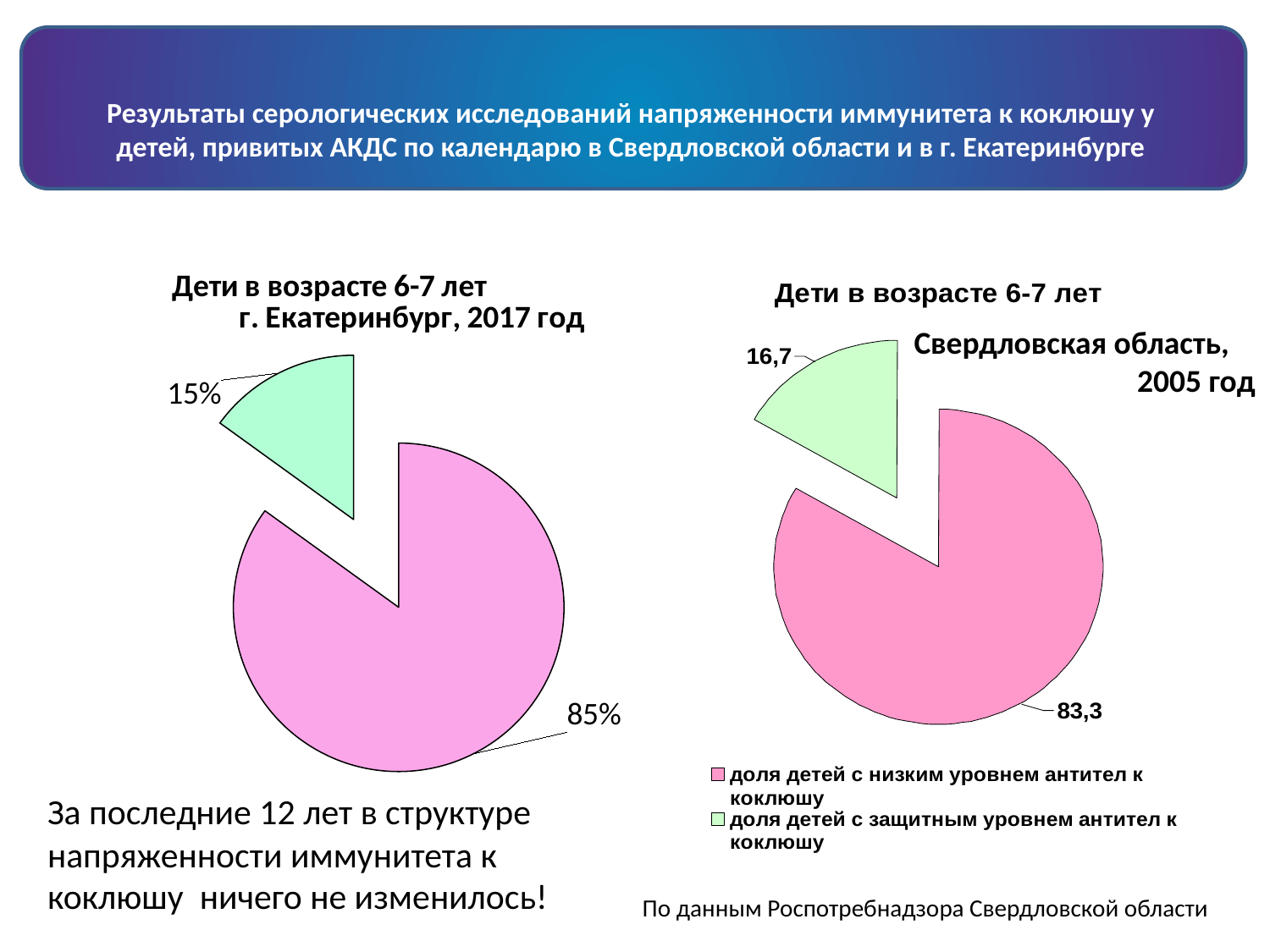
In the left chart (г. Екатеринбург, 2017 год), what is the value of the larger pink slice? 85% In the right chart (Свердловская область, 2005 год), what colour represents доля детей с защитным уровнем антител к коклюшу? green In the right chart (Свердловская область, 2005 год), what is the value of the pink slice (доля детей с низким уровнем антител к коклюшу)? 83,3 In the right chart (Свердловская область, 2005 год), what is the value of the green slice (доля детей с защитным уровнем антител к коклюшу)? 16,7 What kind of chart is the left chart (г. Екатеринбург, 2017 год)? pie chart In the left chart (г. Екатеринбург, 2017 год), what is the difference between the two slices? 70% How many entries does the legend on the right chart (Свердловская область, 2005 год) list? 2 How many slices does the left chart (г. Екатеринбург, 2017 год) have? 2 In the left chart (г. Екатеринбург, 2017 год), what is the value of the smaller green slice? 15% In the right chart (Свердловская область, 2005 год), which slice is the smallest? доля детей с защитным уровнем антител к коклюшу (16,7) In the right chart (Свердловская область, 2005 год), which slice is the largest? доля детей с низким уровнем антител к коклюшу (83,3) In the right chart (Свердловская область, 2005 год), what is the difference between the two slices? 66,6